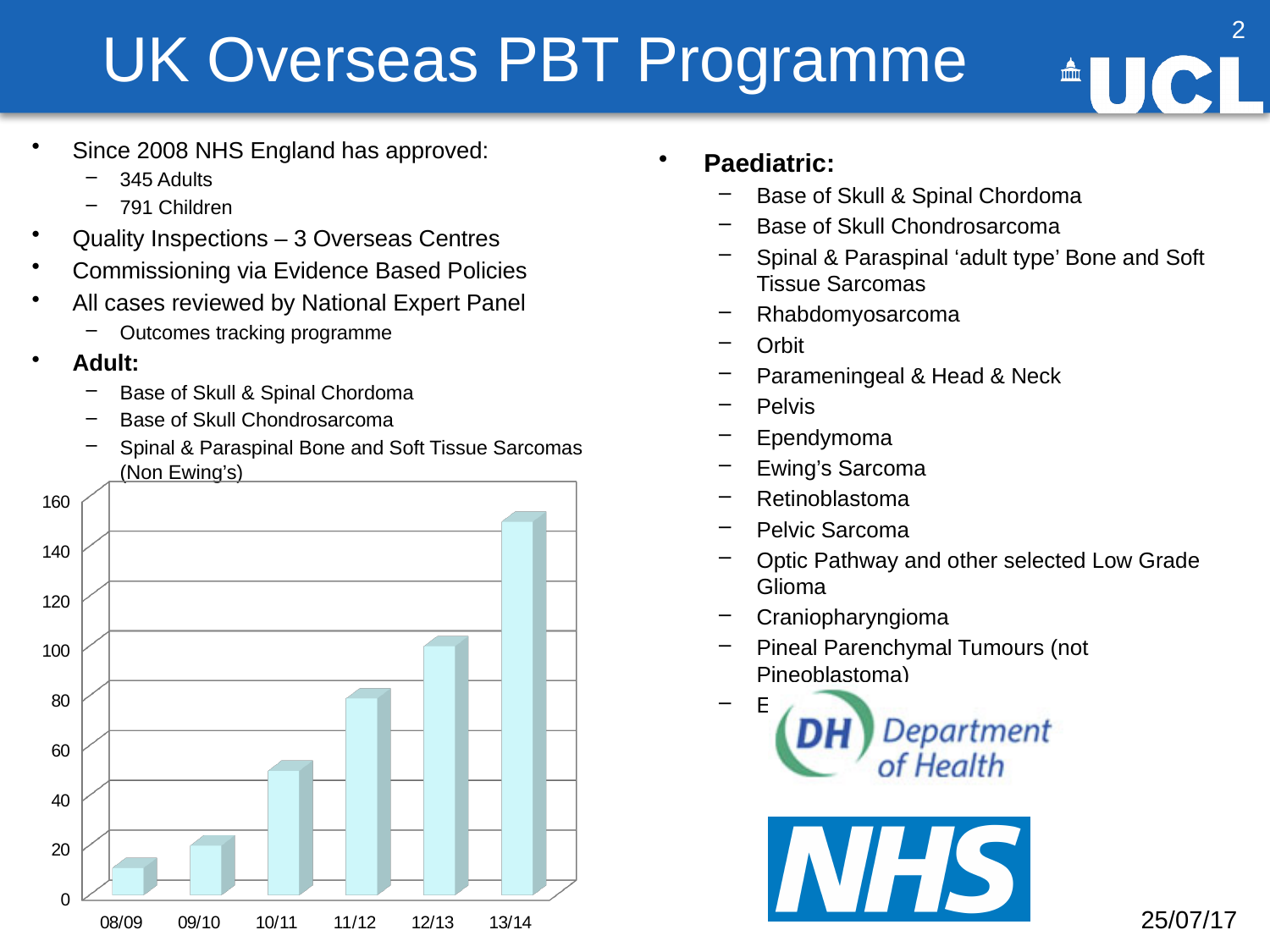
Is the value for 13/14 greater or less than 140? greater What kind of chart is shown on the slide? bar chart Do the values rise or fall from 08/09 to 13/14 along the x axis? rise Which category has the lowest bar in the chart? 08/09 How many categories are shown on the x axis of the chart? 6 Which is larger, the value for 12/13 or the value for 11/12? 12/13 Which category has the highest bar in the chart? 13/14 Is the value for 11/12 greater or less than 60? greater What is the highest value shown on the y axis of the chart? 160 Is the value for 08/09 greater or less than 20? less